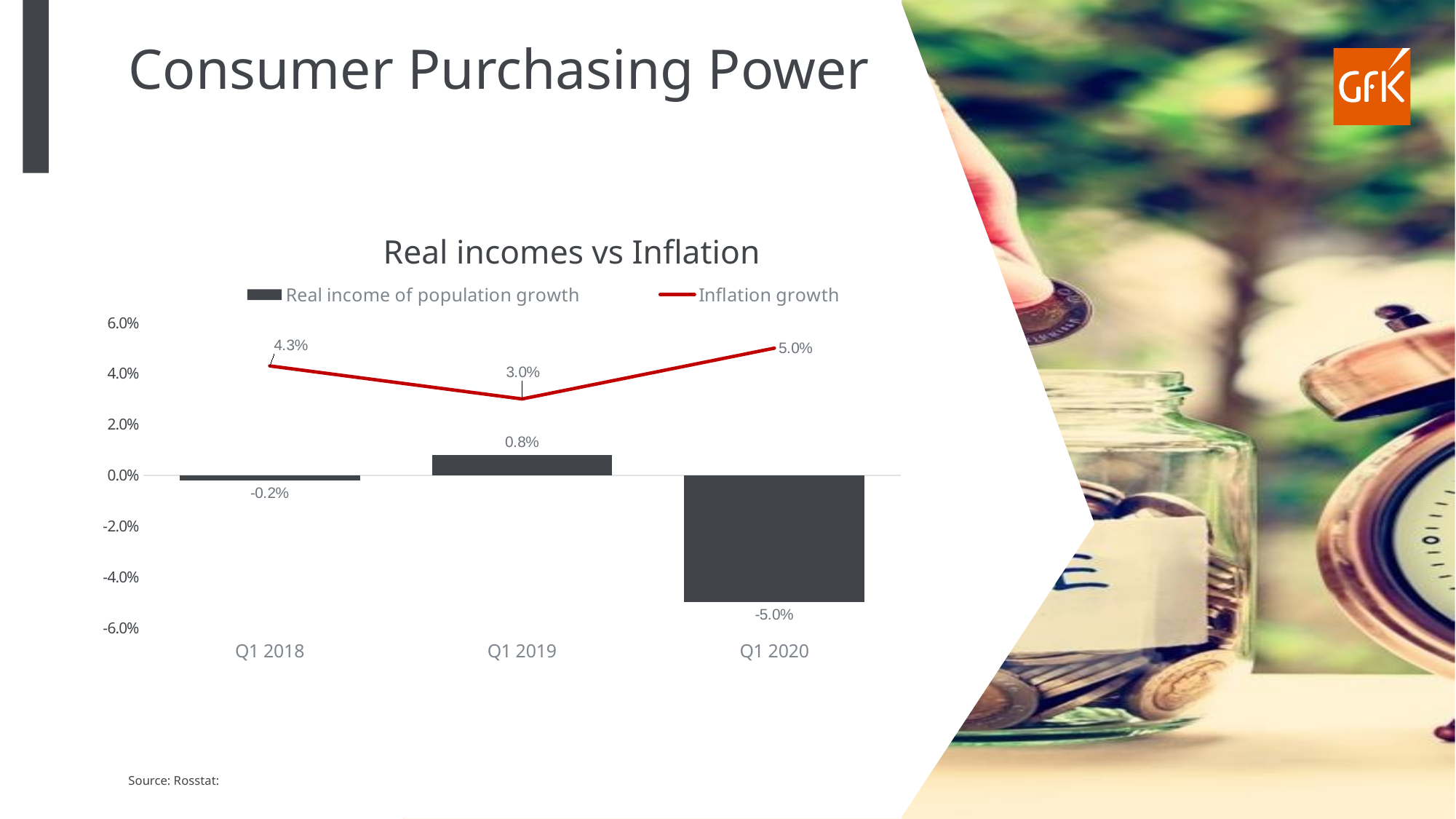
What is the difference between Inflation growth and Real income of population growth in Q1 2020? 10.0% What is the Inflation growth value for Q1 2018? 4.3% Which quarter has the highest Inflation growth? Q1 2020 What kind of chart is used to show Real income of population growth? Bar chart What is the title of the chart? Real incomes vs Inflation What is the Real income of population growth value for Q1 2019? 0.8% How many quarters are shown on the x axis? 3 Which is larger in Q1 2018: Inflation growth or Real income of population growth? Inflation growth What is the Inflation growth value for Q1 2019? 3.0% How many series does the legend list? 2 What is the Real income of population growth value for Q1 2020? -5.0% Which quarter has the lowest Real income of population growth? Q1 2020